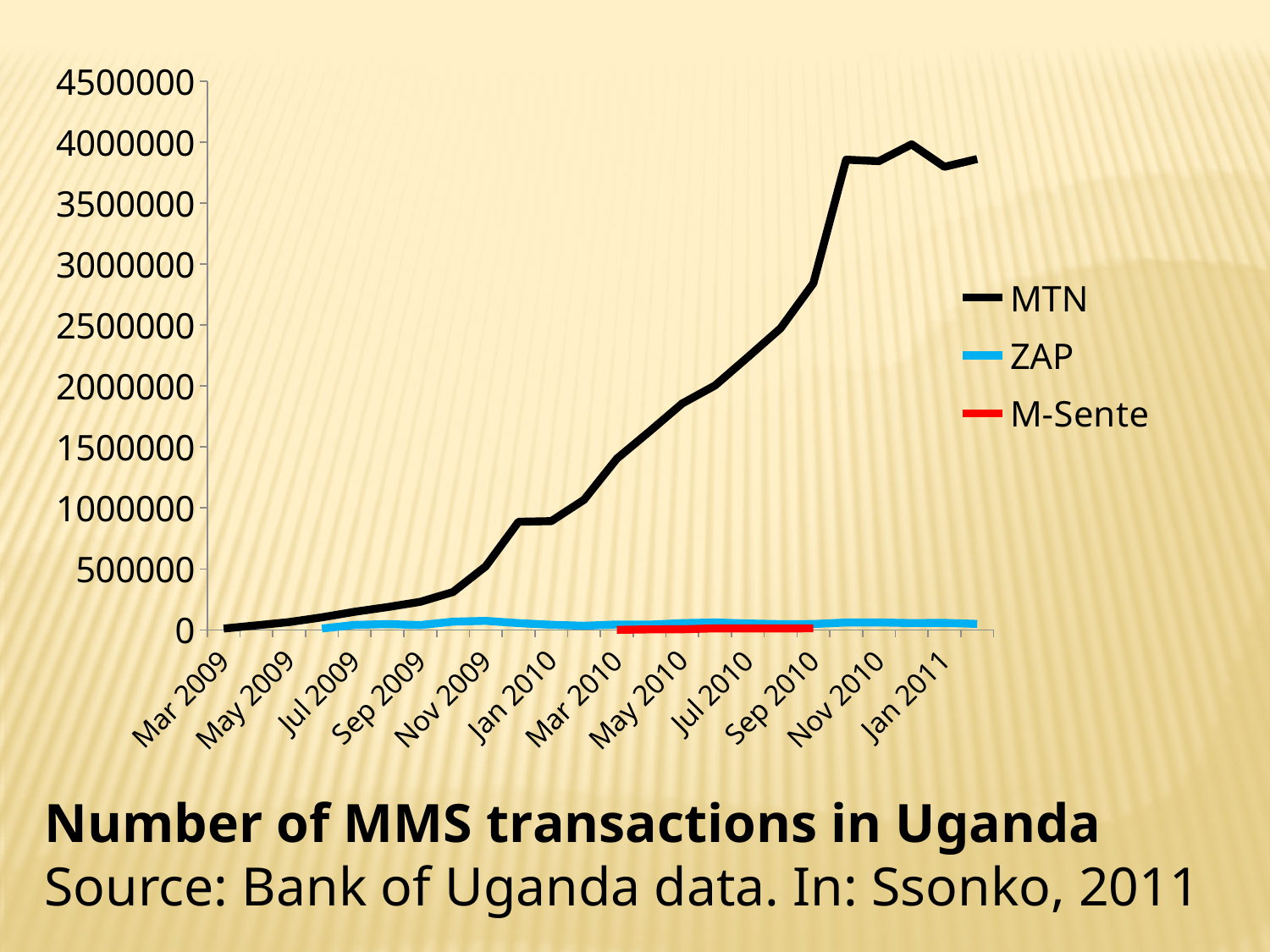
How many series does the legend list? 3 Is the value for MTN at Sep 2010 greater or less than 2500000? greater How many month labels are shown on the x axis? 12 Which colour is used for the M-Sente line? red What is the title of the chart? Number of MMS transactions in Uganda Which is larger at Jan 2011, the value for MTN or the value for ZAP? MTN Is the value for ZAP at Jan 2011 greater or less than 500000? less Is the value for MTN at Jan 2010 greater or less than 1000000? less Which series reaches the highest number of transactions? MTN Does the MTN line rise or fall overall from Mar 2009 to Jan 2011? rise What kind of chart is shown on the slide? line chart